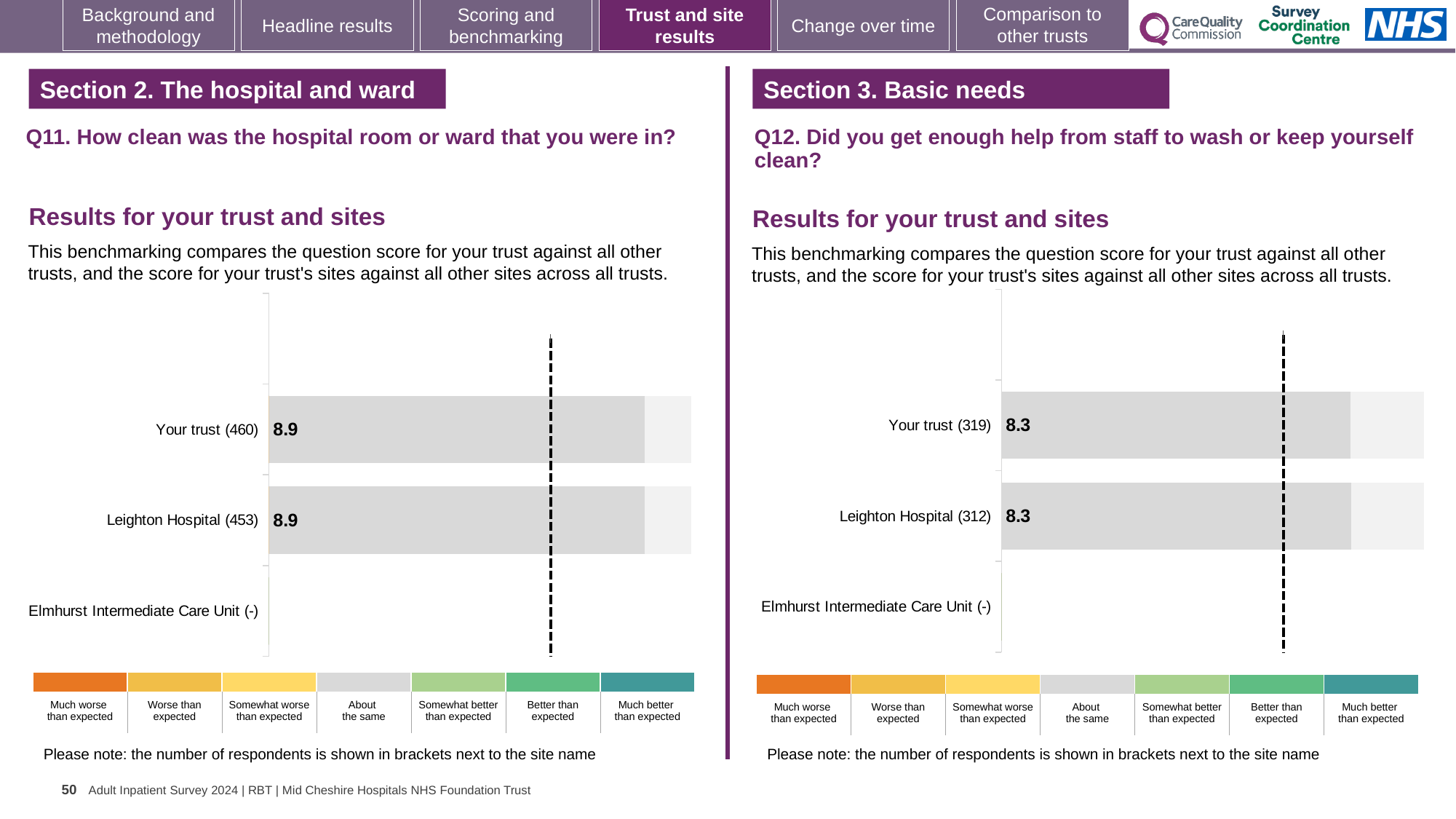
How many site/trust categories are listed on the y axis of the Q11 chart (left)? 3 How many site/trust categories are listed on the y axis of the Q12 chart (right)? 3 In the Q12 chart (right), how many respondents are shown in brackets for Your trust? 319 In the Q12 chart (right), what is the difference between the scores for Your trust and Leighton Hospital? 0.0 In the Q11 chart (left), how many respondents are shown in brackets for Leighton Hospital? 453 What kind of chart is used for the Q11 results (left)? Bar chart In the Q12 chart (right), what is the score for Leighton Hospital? 8.3 Is the score for Your trust in the Q11 chart (left) larger or smaller than the score for Your trust in the Q12 chart (right)? larger In the Q11 chart (left), what is the score for Your trust? 8.9 In the Q11 chart (left), what is the score for Leighton Hospital? 8.9 In the Q11 chart (left), what is the difference between the scores for Your trust and Leighton Hospital? 0.0 In the Q12 chart (right), what is the score for Your trust? 8.3